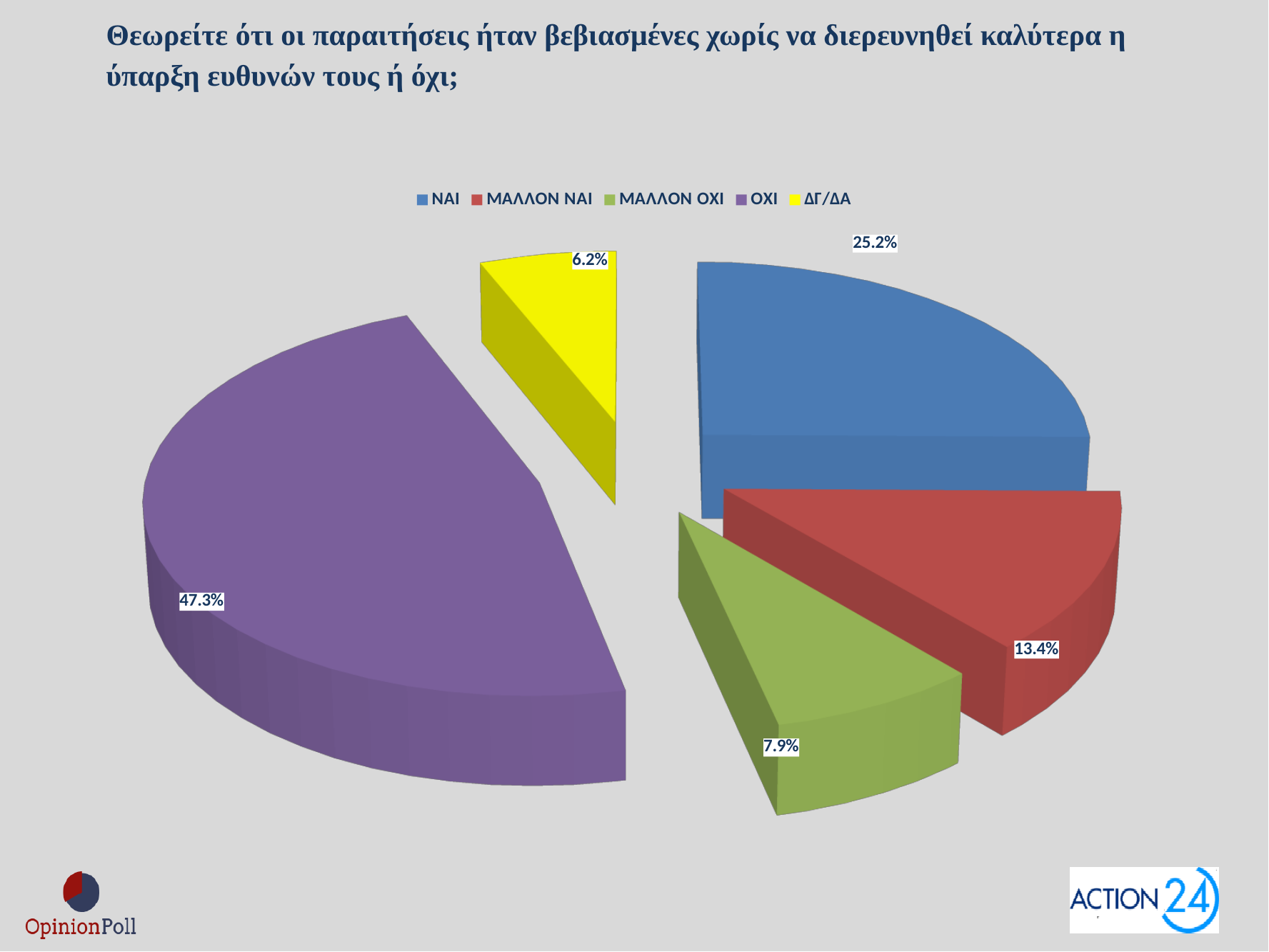
What percentage is shown for ΝΑΙ? 25.2% What percentage is shown for ΟΧΙ? 47.3% What kind of chart is shown on the slide? Pie chart Which category has the smallest share of the pie? ΔΓ/ΔΑ What percentage is shown for ΔΓ/ΔΑ? 6.2% Which category has the largest share of the pie? ΟΧΙ What percentage is shown for ΜΑΛΛΟΝ ΟΧΙ? 7.9% What percentage is shown for ΜΑΛΛΟΝ ΝΑΙ? 13.4% What colour is the slice for ΟΧΙ? Purple What is the difference in percentage points between ΟΧΙ and ΝΑΙ? 22.1 How many slices does the pie chart have? 5 Which is larger, the share for ΜΑΛΛΟΝ ΝΑΙ or the share for ΜΑΛΛΟΝ ΟΧΙ? ΜΑΛΛΟΝ ΝΑΙ